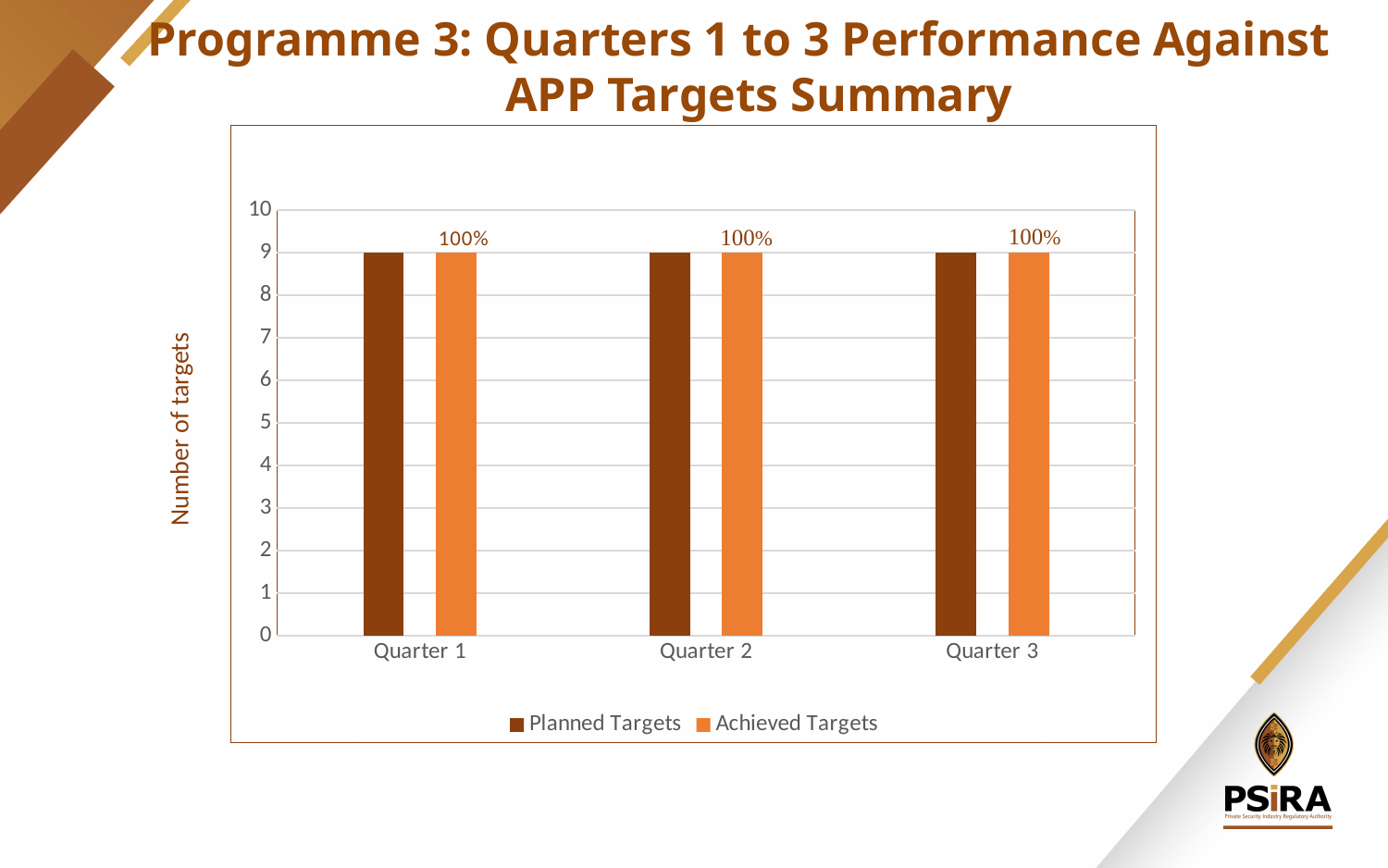
What is the difference between Planned Targets and Achieved Targets in Quarter 1? 0 What is the value of Planned Targets for Quarter 1? 9 What kind of chart is shown on the slide? bar chart What is the value of Achieved Targets for Quarter 2? 9 What percentage label is shown above the Achieved Targets bar for Quarter 3? 100% Do the Planned Targets values rise, fall, or stay the same from Quarter 1 to Quarter 3? stay the same Is the value for Achieved Targets in Quarter 2 greater or less than 5? greater How many series does the legend list? 2 What is the label of the y axis? Number of targets Which series is shown in orange in the legend? Achieved Targets What is the value of Planned Targets for Quarter 3? 9 How many quarters are shown on the x axis? 3